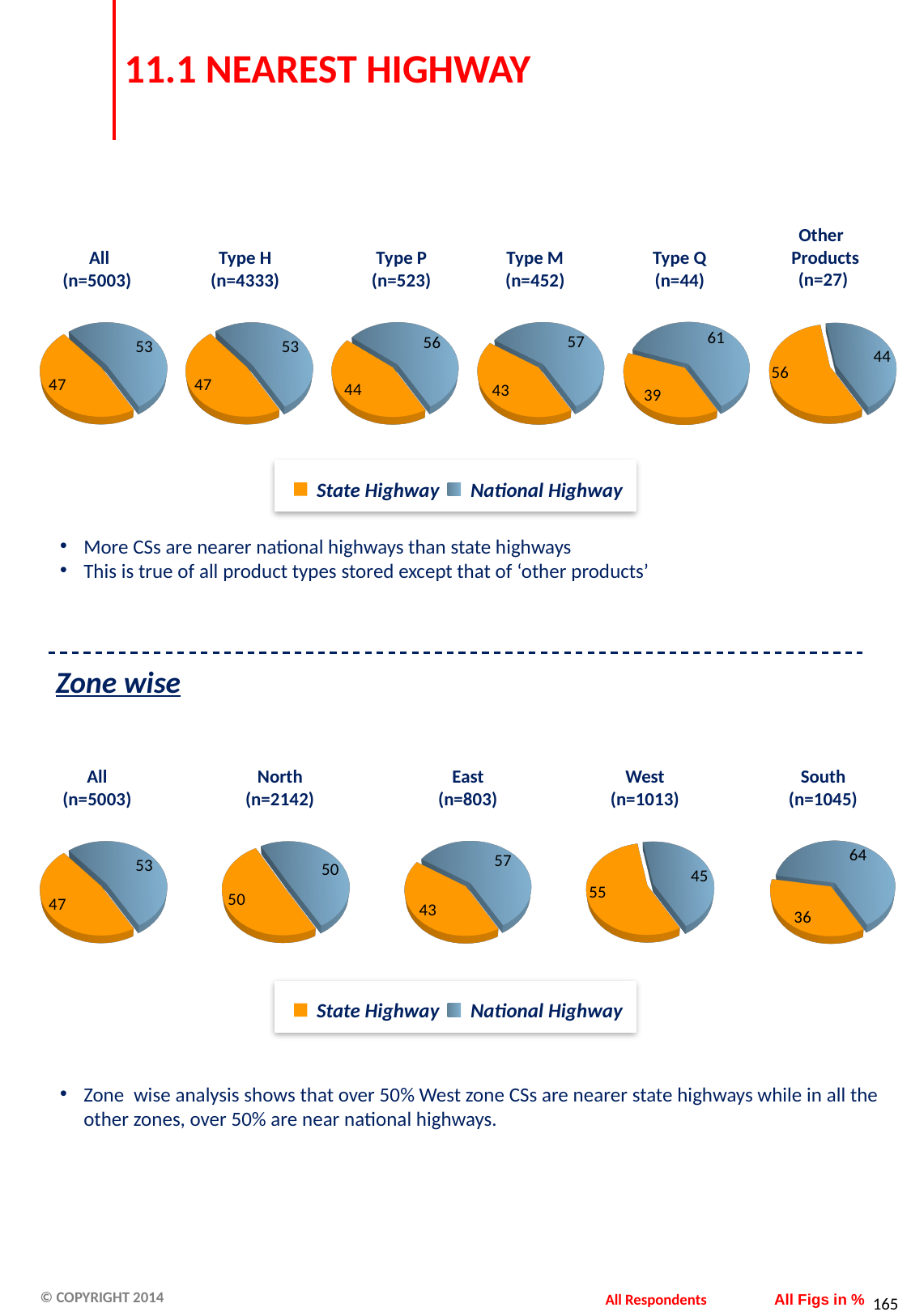
In the top row of pie charts, which chart has the lowest National Highway value? Other Products In the Other Products (n=27) pie chart, which is larger, State Highway or National Highway? State Highway How many series does the legend below the top row of pie charts list? 2 What type of chart is used for the All (n=5003) chart in the top row? Pie chart In the top row of pie charts, what is the State Highway value for Type Q (n=44)? 39 In the Type P (n=523) pie chart, what is the difference between the National Highway and State Highway values? 12 How many pie charts are in the Zone wise row? 5 In the Zone wise row of pie charts, what is the State Highway value for West (n=1013)? 55 In the top row of pie charts, which product type has the highest National Highway value? Type Q In the top row of pie charts, what is the National Highway value for Type M (n=452)? 57 In the South (n=1045) pie chart, what is the difference between the National Highway and State Highway values? 28 In the Zone wise row of pie charts, which zone has the highest National Highway value? South